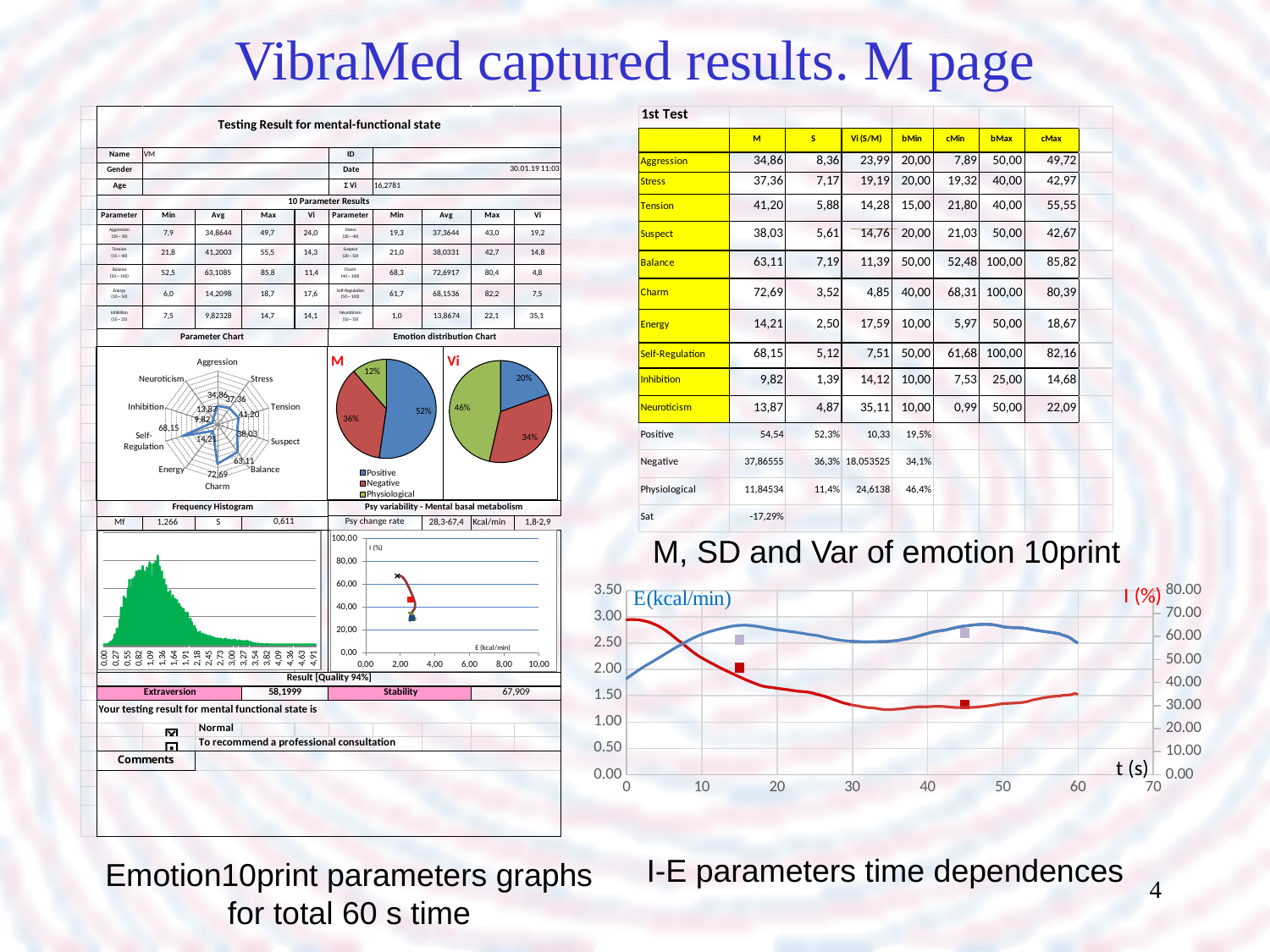
In the I-E parameters time dependences chart, does the red I (%) line overall rise or fall as t (s) increases? fall In the Emotion distribution Chart, what share of the M pie is Positive? 52% In the Emotion distribution Chart, what share of the Vi pie is Positive? 20% In the Parameter Chart radar, what is the value for Charm? 72,69 In the Emotion distribution Chart, which category has the largest slice of the Vi pie? Physiological In the Emotion distribution Chart, what share of the M pie is Negative? 36% What kind of chart is the I-E parameters time dependences chart at the bottom right? line chart In the Parameter Chart radar, what is the difference between the Balance value and the Aggression value? 28,25 In the Parameter Chart radar, which parameter has the lowest value? Inhibition In the Parameter Chart radar, how many parameters are plotted? 10 In the Parameter Chart radar, which is larger, Stress or Tension? Tension